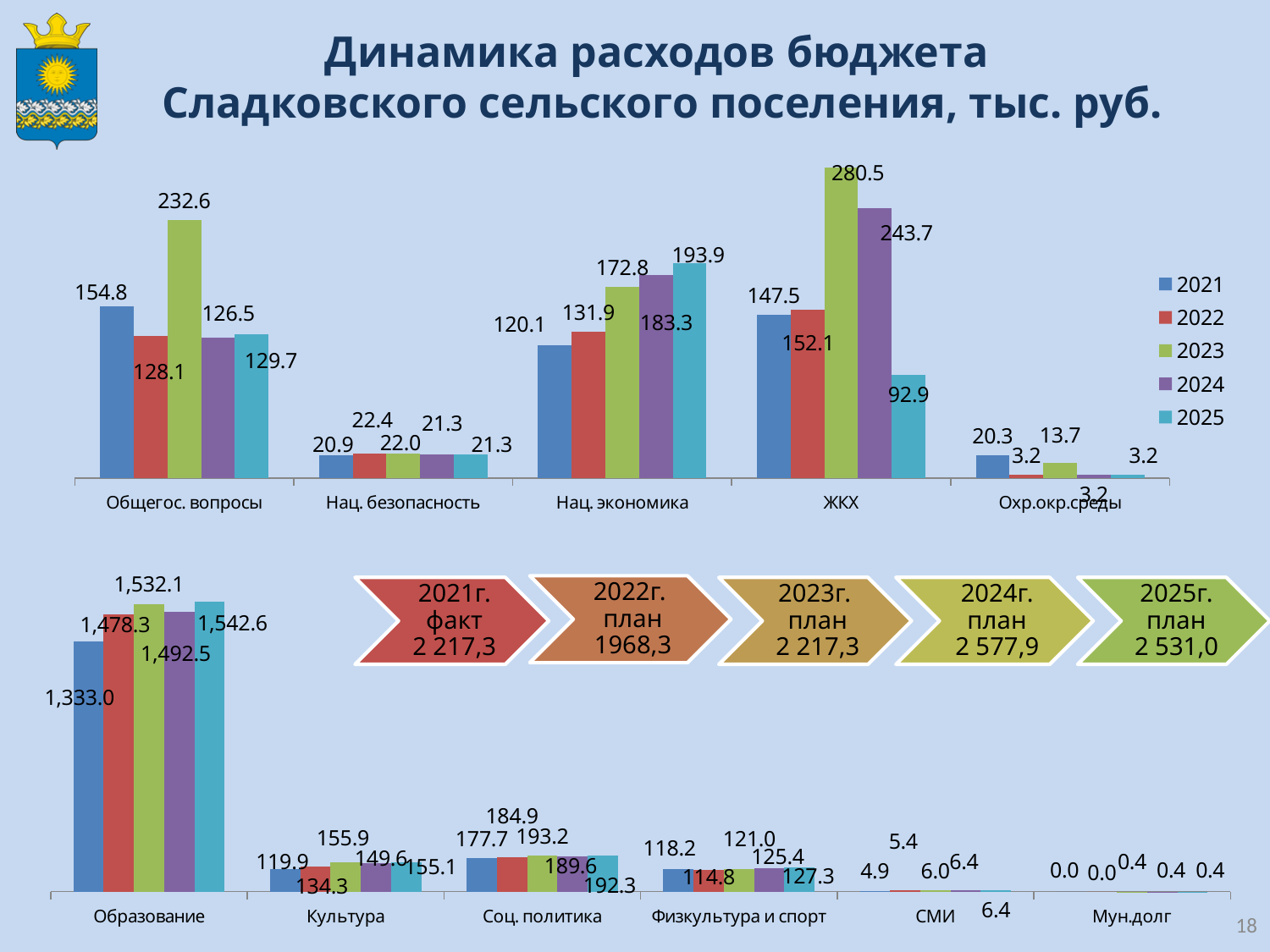
How many categories are shown on the x axis of the bottom chart? 6 In the top chart, which year has the highest value for Общегос. вопросы? 2023 In the top chart, what is the value for ЖКХ in 2023? 280.5 In the bottom chart, what is the value for СМИ in 2024? 6.4 In the bottom chart, which is larger for Культура: the 2022 value or the 2023 value? 2023 In the bottom chart, what is the value for Образование in 2021? 1,333.0 How many series does the legend of the top chart list? 5 In the top chart, do the values for Нац. экономика rise or fall from 2021 to 2025? rise In the top chart, what is the value for Нац. экономика in 2025? 193.9 What kind of chart is the top chart on the slide? bar chart In the top chart, which year has the lowest value for ЖКХ? 2025 In the top chart, what is the difference between the 2023 and 2021 values for Общегос. вопросы? 77.8